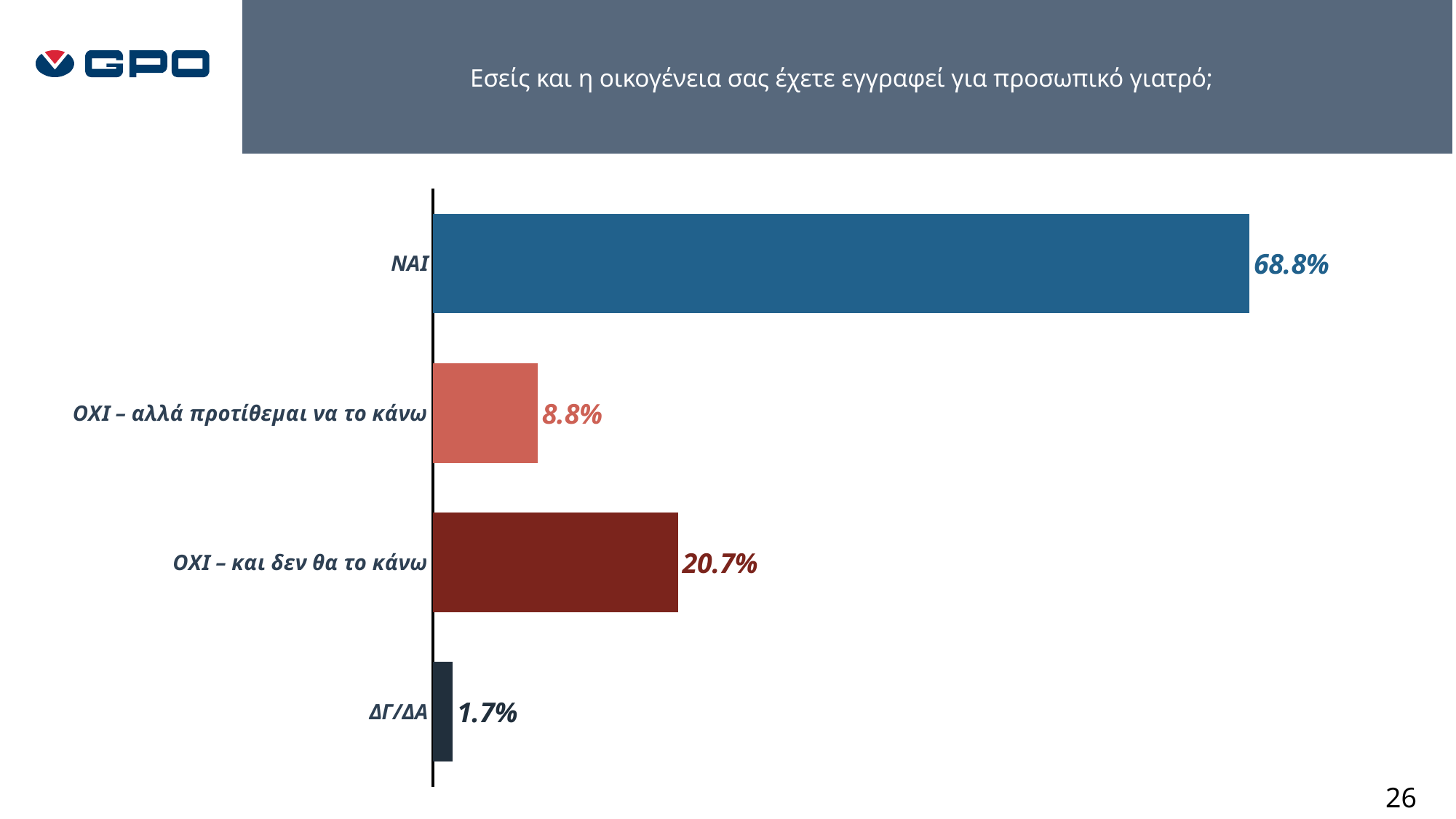
What is the value for ΟΧΙ – και δεν θα το κάνω? 20.7% Which is larger: the value for ΟΧΙ – αλλά προτίθεμαι να το κάνω or the value for ΟΧΙ – και δεν θα το κάνω? ΟΧΙ – και δεν θα το κάνω Which category has the highest value? ΝΑΙ What kind of chart is shown on the slide? Bar chart What is the value for ΟΧΙ – αλλά προτίθεμαι να το κάνω? 8.8% What is the difference between the values for ΝΑΙ and ΟΧΙ – και δεν θα το κάνω? 48.1% Which category has the lowest value? ΔΓ/ΔΑ What is the value for ΔΓ/ΔΑ? 1.7% What is the difference between the values for ΟΧΙ – και δεν θα το κάνω and ΟΧΙ – αλλά προτίθεμαι να το κάνω? 11.9% How many categories are shown in the chart? 4 What is the value for ΝΑΙ? 68.8% What is the title of the slide? Εσείς και η οικογένεια σας έχετε εγγραφεί για προσωπικό γιατρό;